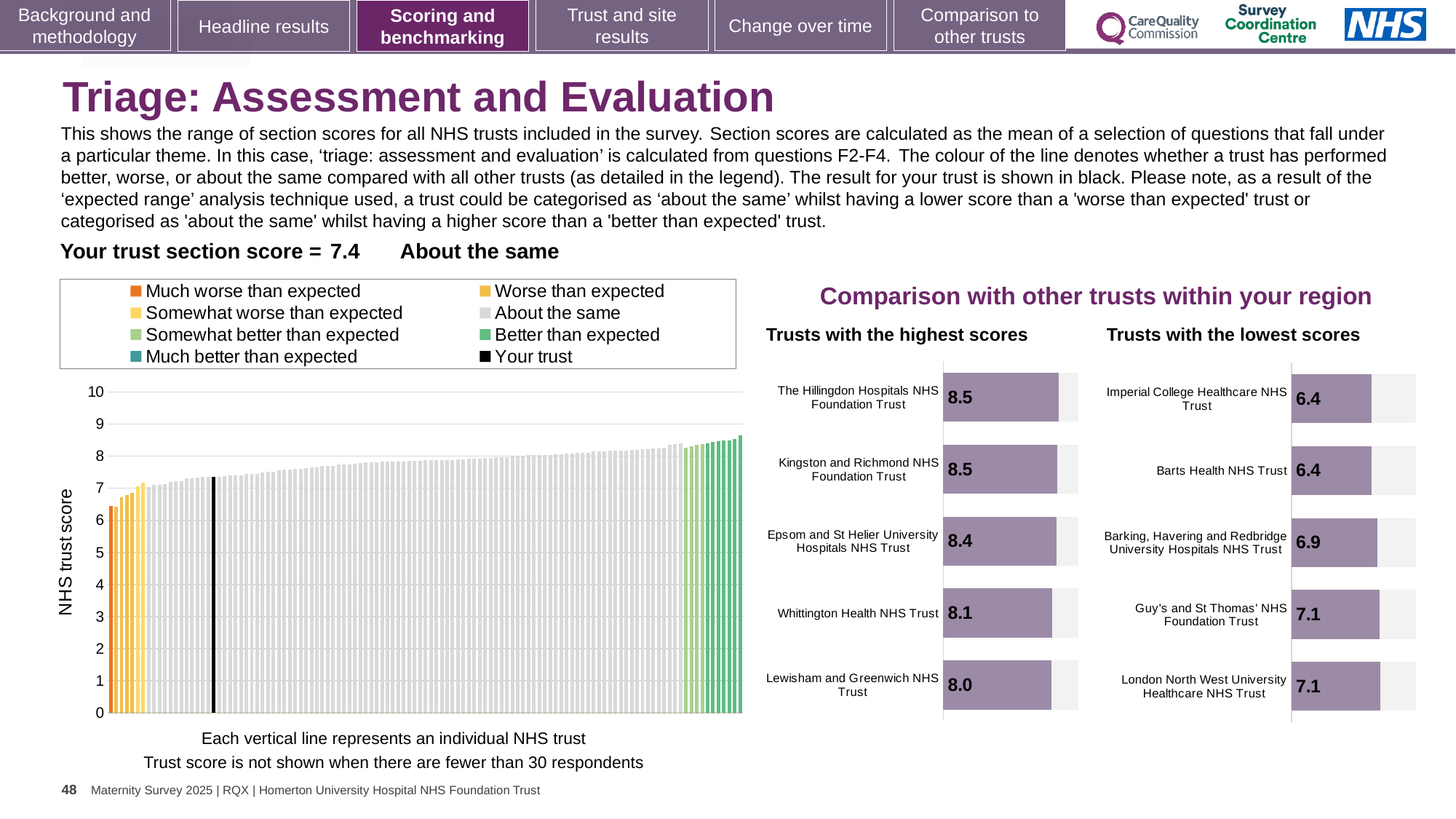
In the 'Trusts with the highest scores' chart, what is the score for Whittington Health NHS Trust? 8.1 In the 'Trusts with the highest scores' chart, which trust has the lowest score shown? Lewisham and Greenwich NHS Trust In the NHS trust score chart on the left, do the bar values rise or fall from left to right? Rise In the 'Trusts with the highest scores' chart, which has the higher score: Whittington Health NHS Trust or Epsom and St Helier University Hospitals NHS Trust? Epsom and St Helier University Hospitals NHS Trust How many trusts are listed in the 'Trusts with the lowest scores' chart? 5 In the 'Trusts with the lowest scores' chart, what is the score for Barking, Havering and Redbridge University Hospitals NHS Trust? 6.9 How many entries does the legend of the NHS trust score chart on the left list? 8 In the NHS trust score chart on the left, what is the section score for your trust (the black bar)? 7.4 In the legend of the NHS trust score chart on the left, what colour represents 'Your trust'? Black What kind of chart is the NHS trust score chart on the left of the slide? Bar chart In the 'Trusts with the lowest scores' chart, what is the difference between the scores of Barking, Havering and Redbridge University Hospitals NHS Trust and Imperial College Healthcare NHS Trust? 0.5 In the 'Trusts with the highest scores' chart, what is the difference between the scores of Epsom and St Helier University Hospitals NHS Trust and Lewisham and Greenwich NHS Trust? 0.4